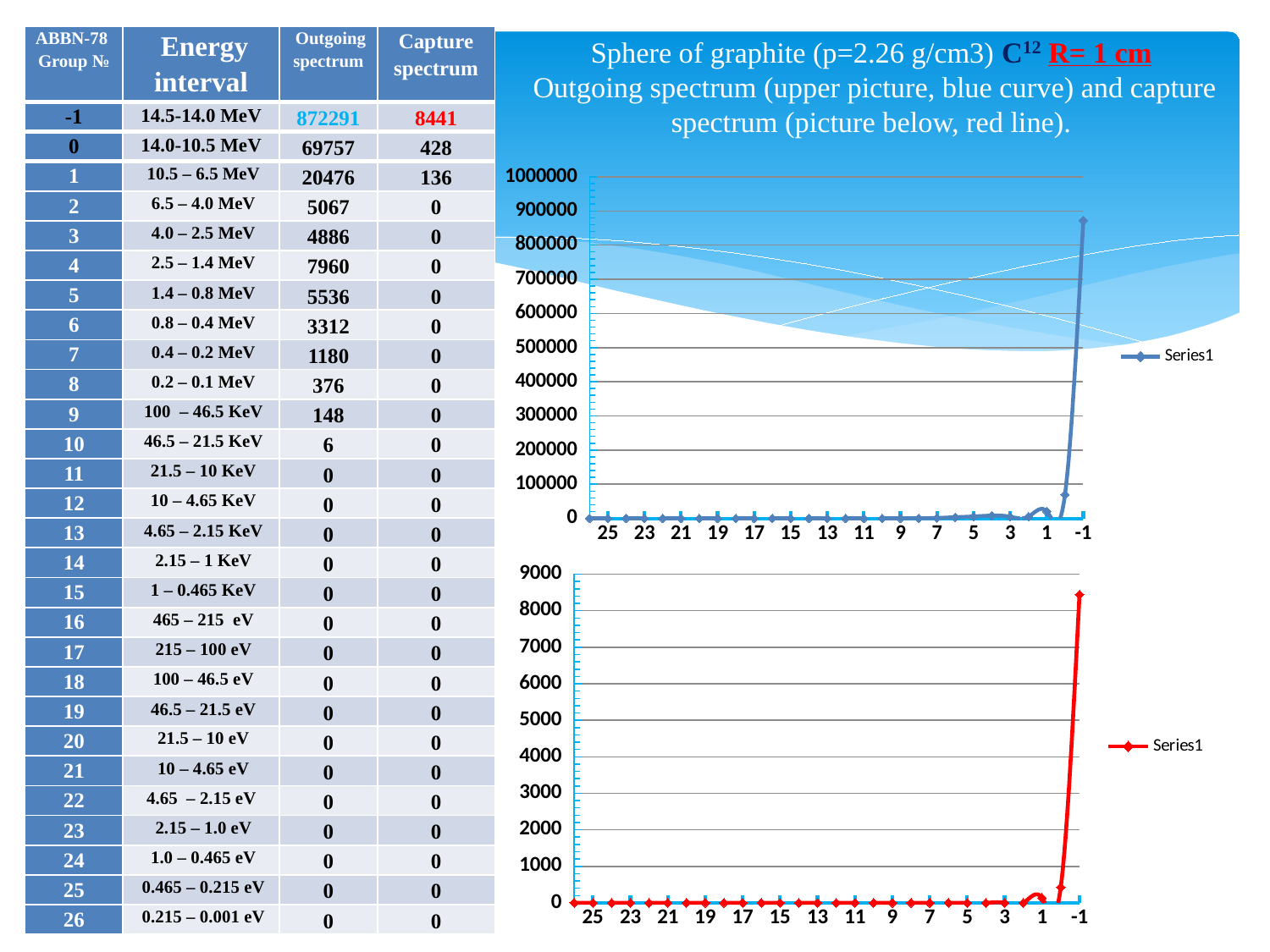
In the upper chart, is the value at category -1 larger or smaller than the value at category 0? larger What is the legend entry shown for the lower chart? Series1 What kind of chart is the lower chart (red line)? line chart In the upper chart, is the value at category -1 greater or less than 800000? greater What kind of chart is the upper chart (blue curve)? line chart How many series does the legend of the upper chart list? 1 In the lower chart, which x-axis category has the highest value? -1 In the upper chart, do the values generally rise or fall moving from category 25 on the left to category -1 on the right? rise In the upper chart, is the value at category 5 greater or less than 100000? less In the lower chart, is the value at category -1 greater or less than 8000? greater In the upper chart, which x-axis category has the highest value? -1